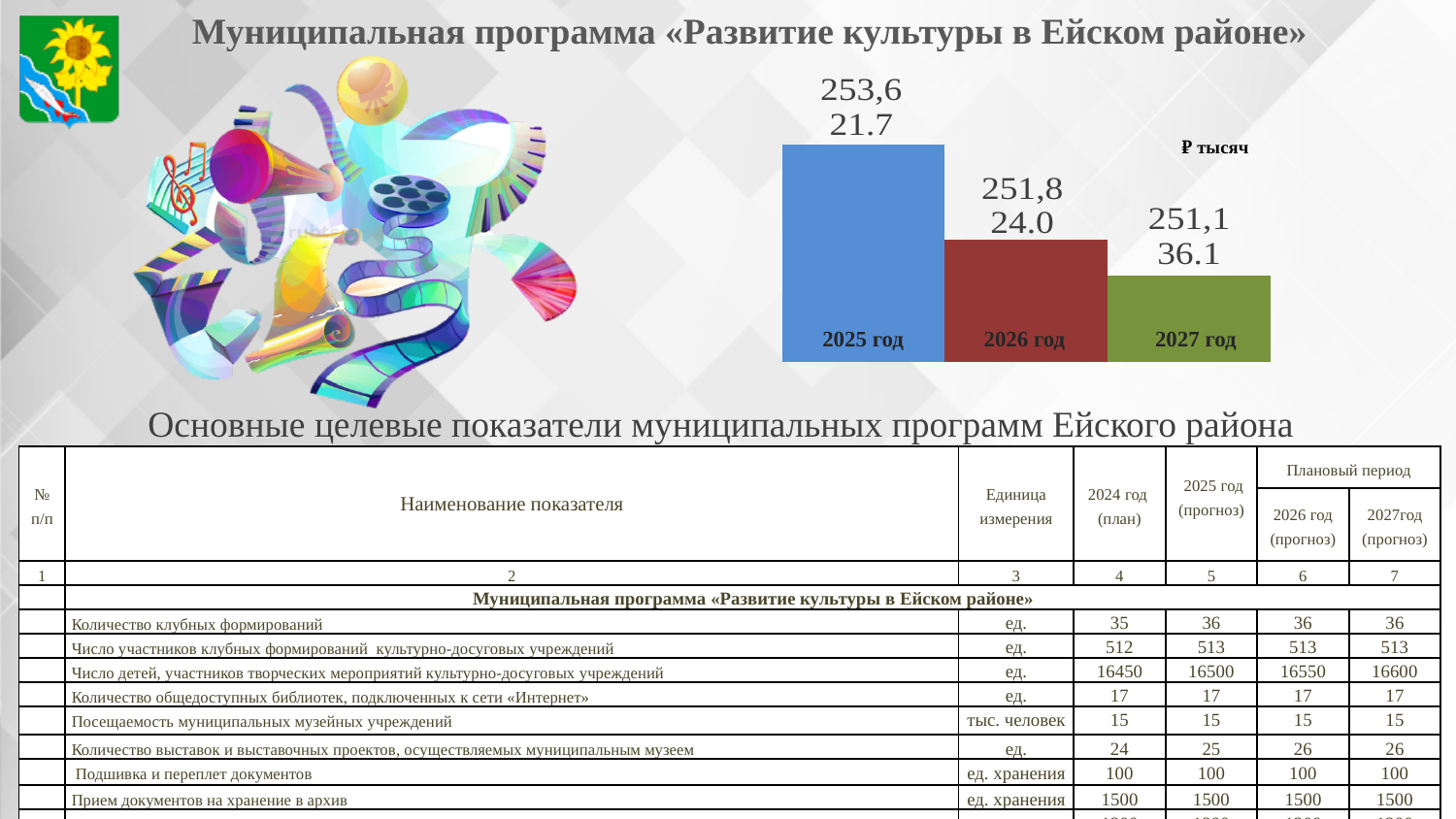
How many bars (years) does the chart show? 3 Which year has the tallest bar in the chart? 2025 год Do the bar values rise or fall from 2025 to 2027? fall What colour is the bar for 2026 год? red Which bar is taller, 2026 год or 2027 год? 2026 год What label is printed above the 2027 год bar? 251,1 36.1 What label is printed above the 2026 год bar? 251,8 24.0 What unit is indicated next to the chart? ₽ тысяч What label is printed above the 2025 год bar? 253,6 21.7 What kind of chart is shown on the slide? bar chart Which bar is taller, 2025 год or 2027 год? 2025 год Which year has the shortest bar in the chart? 2027 год